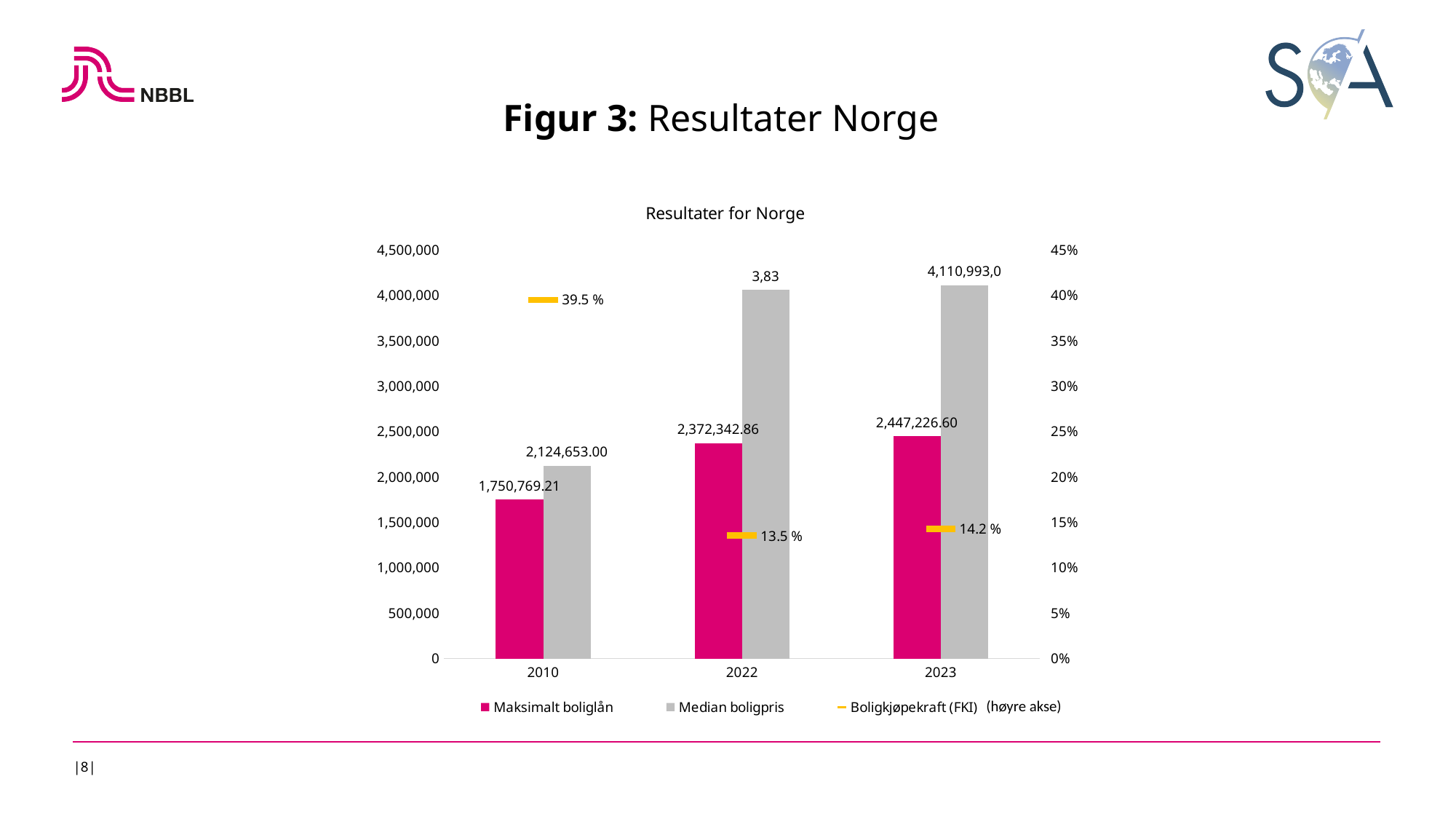
Which year has the highest Boligkjøpekraft (FKI) value? 2010 What is the value of Maksimalt boliglån for 2010? 1,750,769.21 What is the difference between Maksimalt boliglån in 2023 and in 2022? 74,883.74 What is the value of Maksimalt boliglån for 2022? 2,372,342.86 What is the value of Median boligpris for 2010? 2,124,653.00 Which year has the lowest Maksimalt boliglån value? 2010 What is the Boligkjøpekraft (FKI) value for 2010? 39.5 % How many series does the legend list? 3 How many years are shown on the x axis? 3 Is the Median boligpris value for 2023 greater or less than 3,500,000? greater What is the Boligkjøpekraft (FKI) value for 2022? 13.5 % What is the value of Maksimalt boliglån for 2023? 2,447,226.60